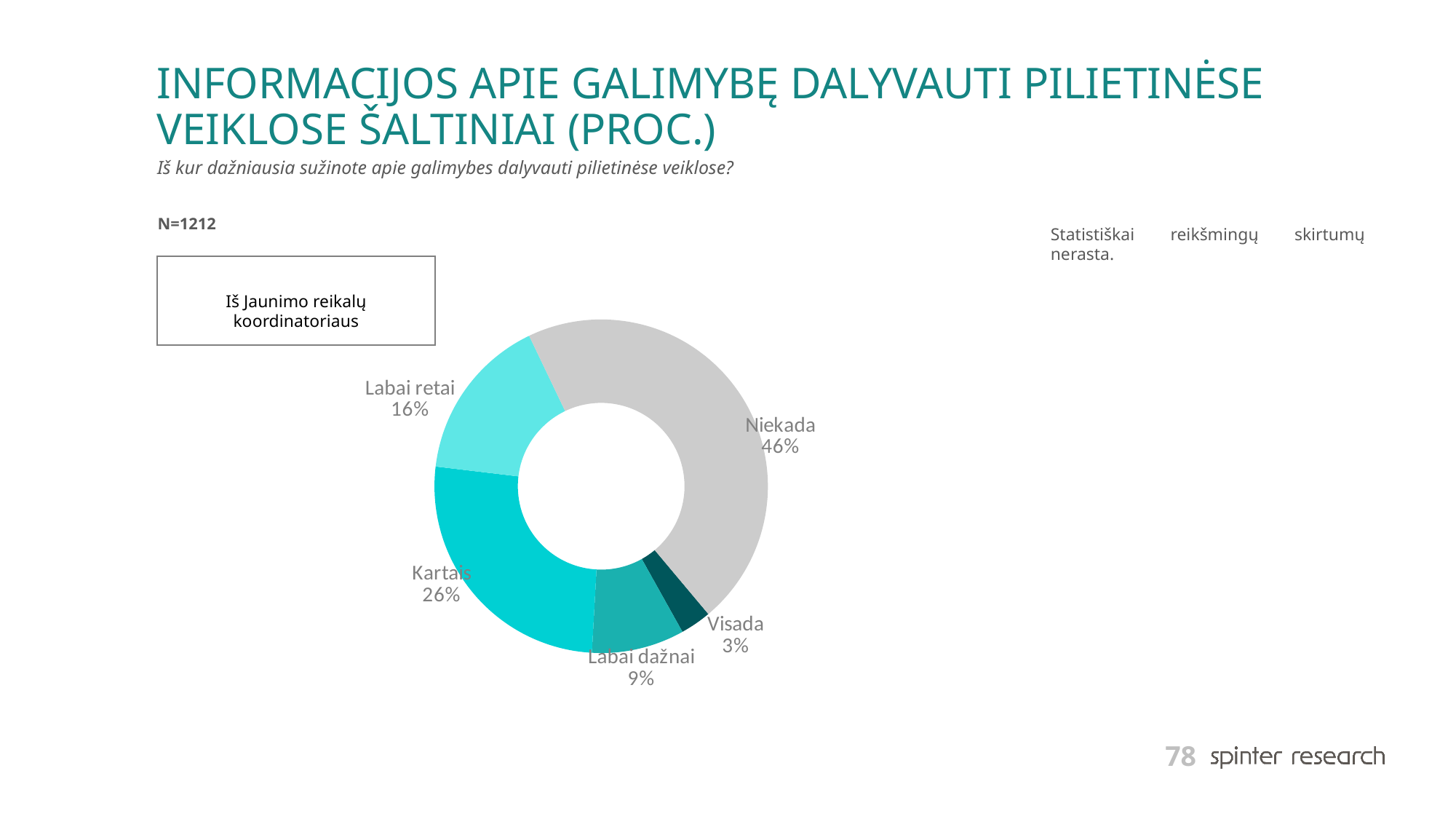
What percentage of respondents answered "Niekada"? 46% Which category has the smallest share of the chart? Visada How many categories are shown in the chart? 5 What percentage of respondents answered "Kartais"? 26% What kind of chart is shown on the slide? Doughnut chart What is the sample size (N) stated on the slide? N=1212 What is the difference in percentage points between "Niekada" and "Kartais"? 20 Which is larger, the share for "Labai retai" or the share for "Labai dažnai"? Labai retai What percentage of respondents answered "Labai dažnai"? 9% Which category has the largest share of the chart? Niekada What percentage of respondents answered "Visada"? 3% What percentage of respondents answered "Labai retai"? 16%